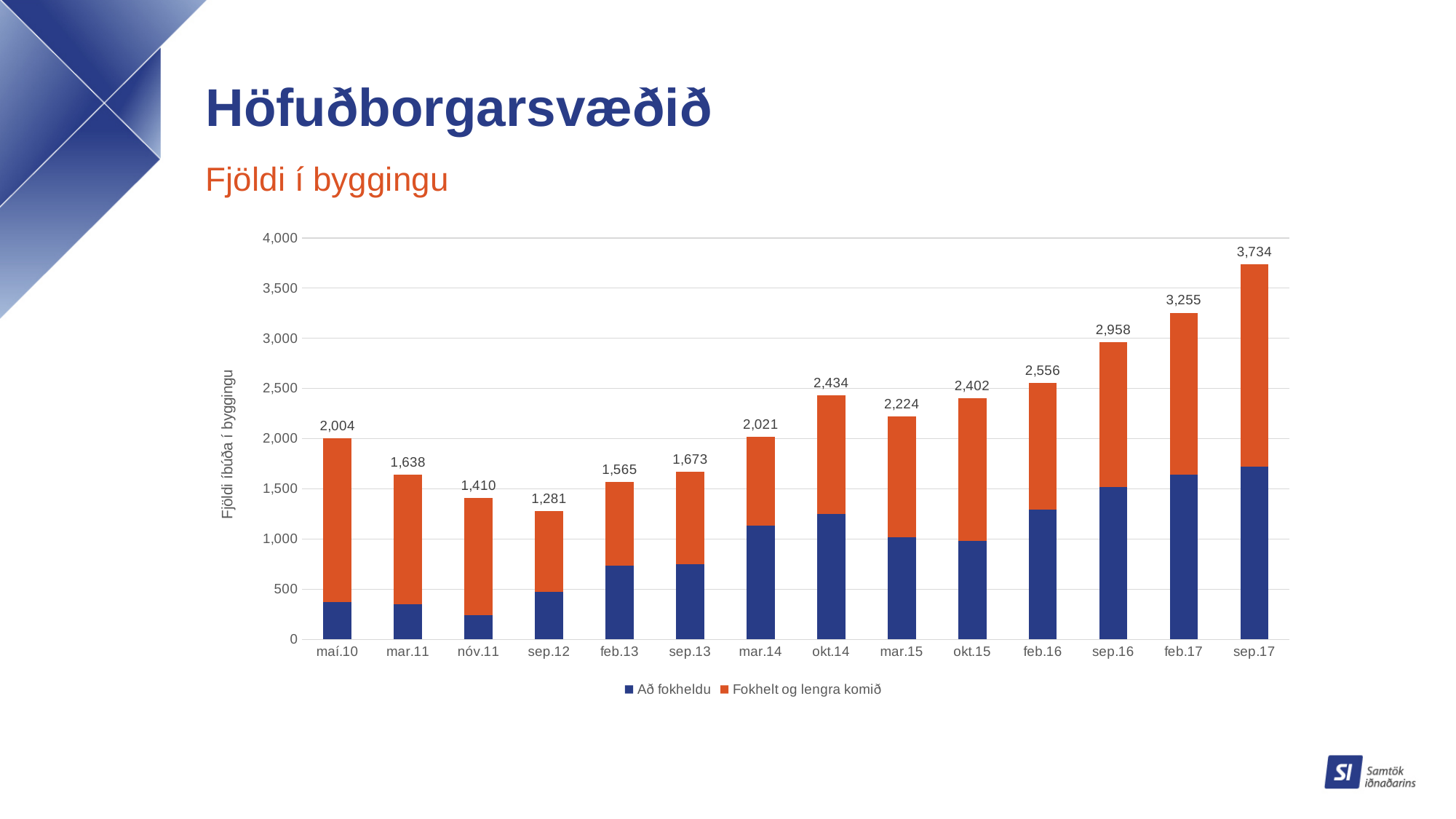
What is the total value labelled on the bar for maí.10? 2,004 What is the total number of dwellings under construction shown for sep.17? 3,734 What kind of chart is shown on the slide? Stacked bar chart Which series is shown in orange in the legend? Fokhelt og lengra komið What is the difference between the total for sep.17 and the total for feb.17? 479 Which period has the lowest total number of dwellings under construction? sep.12 How many periods are shown on the x axis? 14 Which period has the highest total number of dwellings under construction? sep.17 Is the 'Að fokheldu' value for sep.17 greater or less than 1,500? greater Which period has a larger total, okt.14 or mar.15? okt.14 How many series does the legend list? 2 Is the 'Að fokheldu' value for nóv.11 greater or less than 500? less